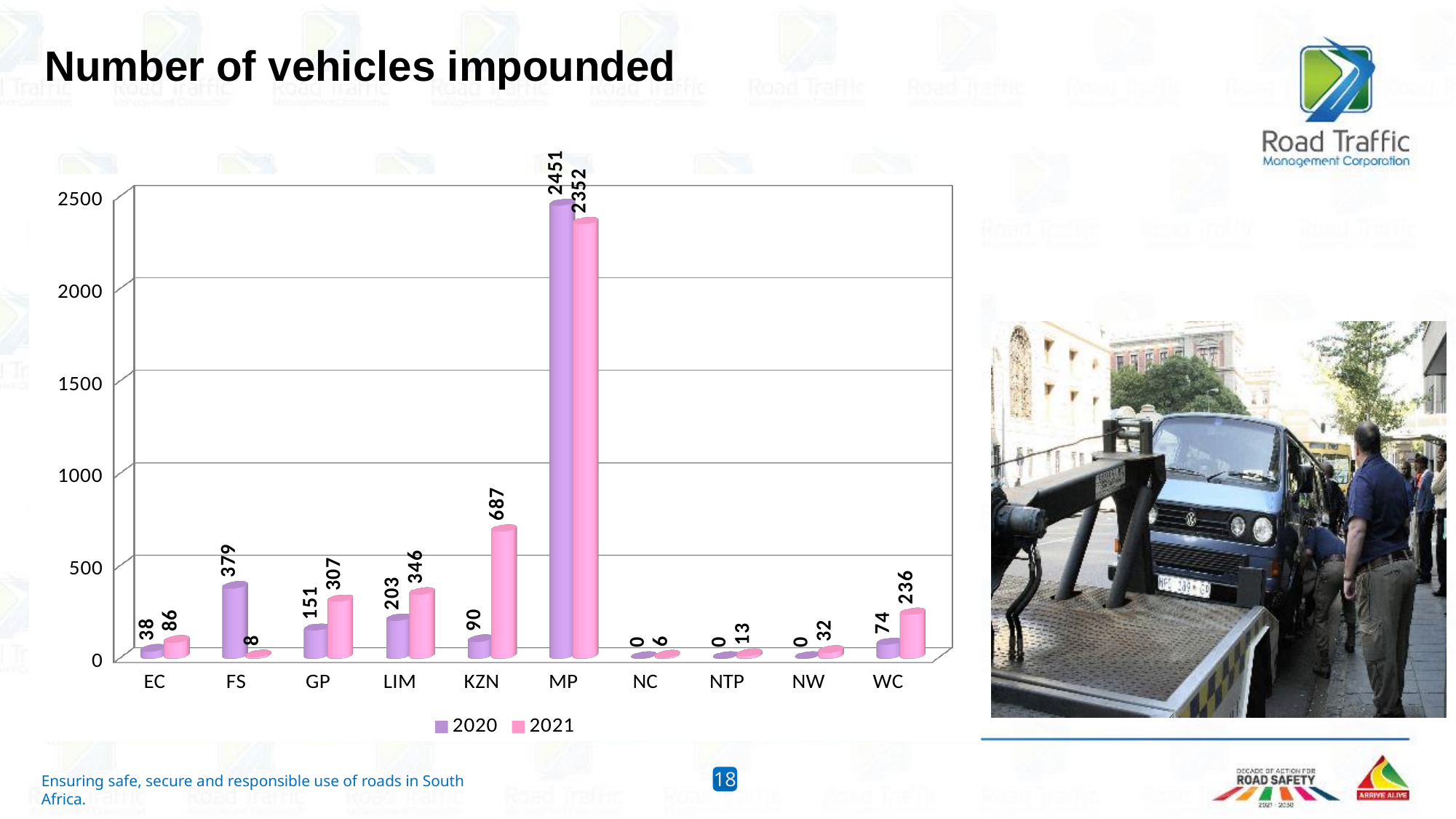
Which colour represents the 2021 series in the chart? Pink What is the value for FS in 2021? 8 Which is larger for FS: the 2020 value or the 2021 value? 2020 Is the value for KZN in 2021 greater or less than 500? greater What is the number of vehicles impounded in MP in 2020? 2451 How many provinces are shown on the x axis of the chart? 10 What is the difference between the 2020 and 2021 values for MP? 99 How many series does the legend list? 2 What kind of chart is shown on the slide? Bar chart Which province has the lowest number of vehicles impounded in 2021? NC What is the number of vehicles impounded in KZN in 2021? 687 Which province has the highest number of vehicles impounded in 2021? MP